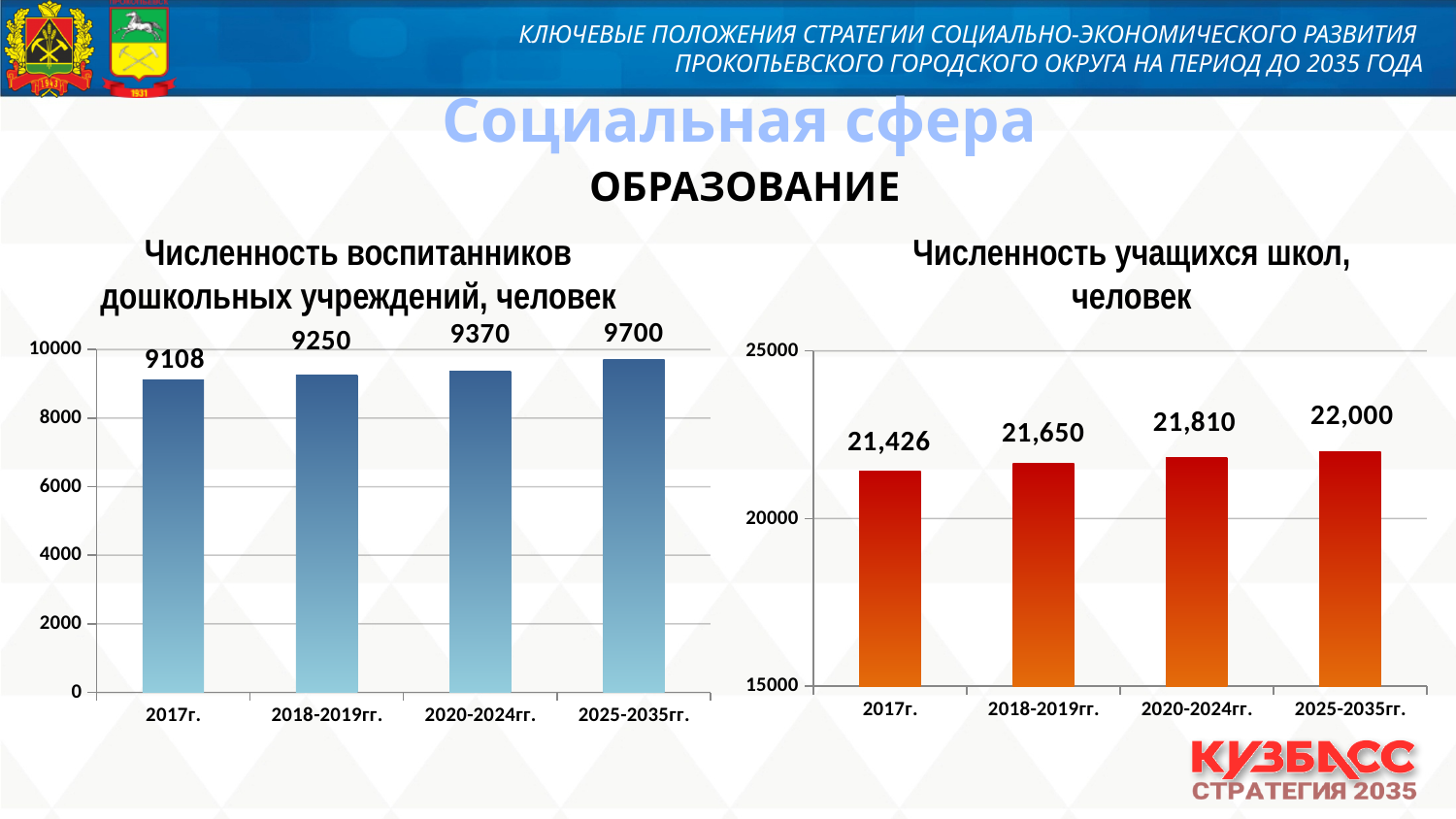
How many categories are shown on the x axis of the right chart (Численность учащихся школ, человек)? 4 In the right chart (Численность учащихся школ, человек), what is the value for 2025-2035гг.? 22,000 In the right chart (Численность учащихся школ, человек), what is the difference between the values for 2020-2024гг. and 2018-2019гг.? 160 In the left chart (Численность воспитанников дошкольных учреждений, человек), which category has the highest value? 2025-2035гг. In the left chart (Численность воспитанников дошкольных учреждений, человек), what is the value for 2017г.? 9108 In the right chart (Численность учащихся школ, человек), which category has the lowest value? 2017г. In the left chart (Численность воспитанников дошкольных учреждений, человек), what is the difference between the values for 2025-2035гг. and 2017г.? 592 What kind of chart is the left chart (Численность воспитанников дошкольных учреждений, человек)? bar chart In the left chart (Численность воспитанников дошкольных учреждений, человек), is the value for 2020-2024гг. greater or less than 8000? greater In the right chart (Численность учащихся школ, человек), do the values rise or fall from 2017г. to 2025-2035гг.? rise What is the title of the right chart? Численность учащихся школ, человек In the right chart (Численность учащихся школ, человек), which is larger: the value for 2018-2019гг. or the value for 2020-2024гг.? 2020-2024гг.